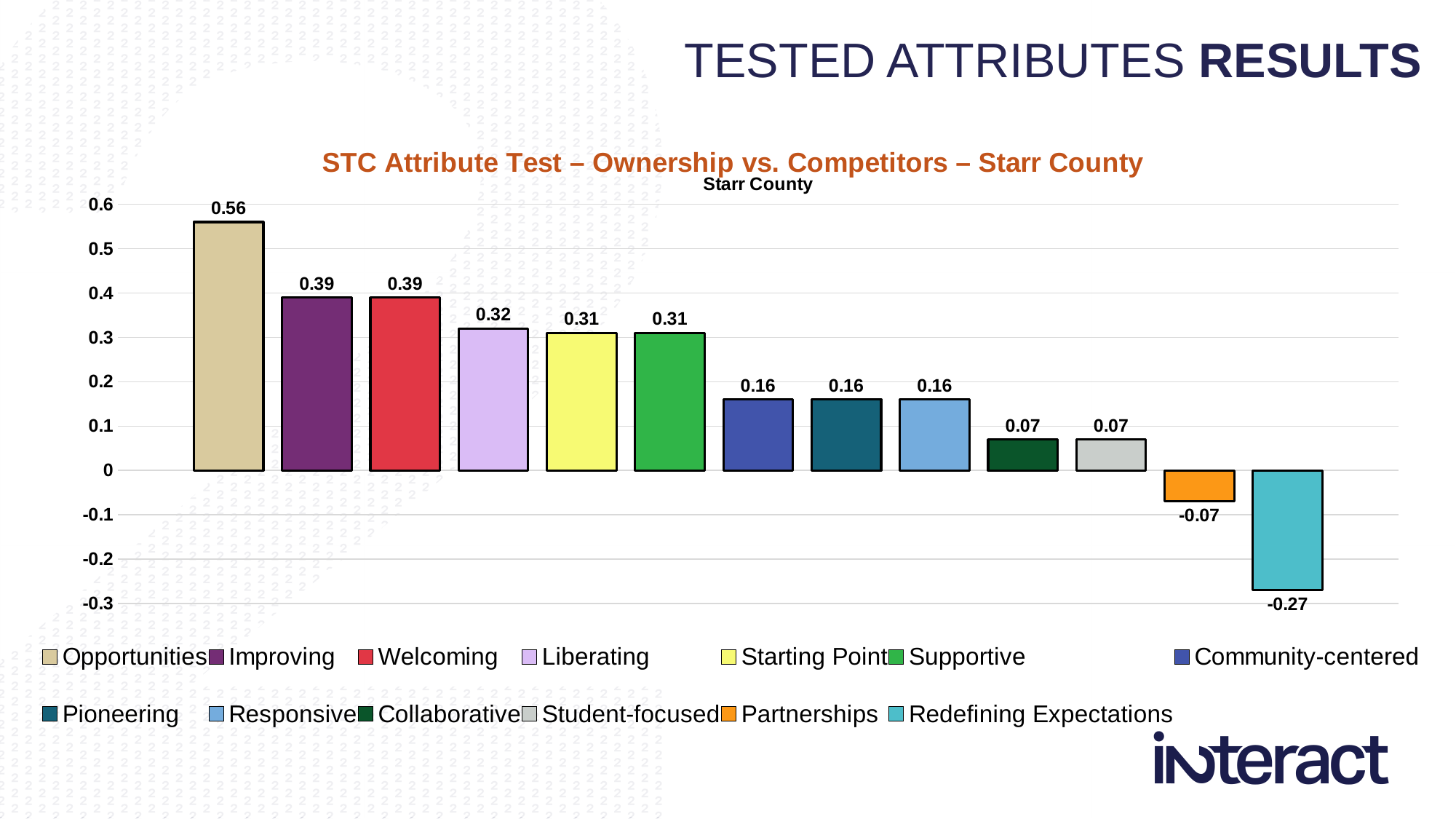
What is the value for Liberating? 0.32 How many entries does the legend list? 13 What is the value for Redefining Expectations? -0.27 What is the value for Partnerships? -0.07 Which is larger, the value for Supportive or the value for Pioneering? Supportive What is the difference between the values for Opportunities and Improving? 0.17 Which attribute has the lowest value? Redefining Expectations What is the title of the chart? STC Attribute Test – Ownership vs. Competitors – Starr County Which attribute has the highest value? Opportunities What kind of chart is shown on the slide? Bar chart What is the value for Opportunities? 0.56 How many bars are plotted in the chart? 13